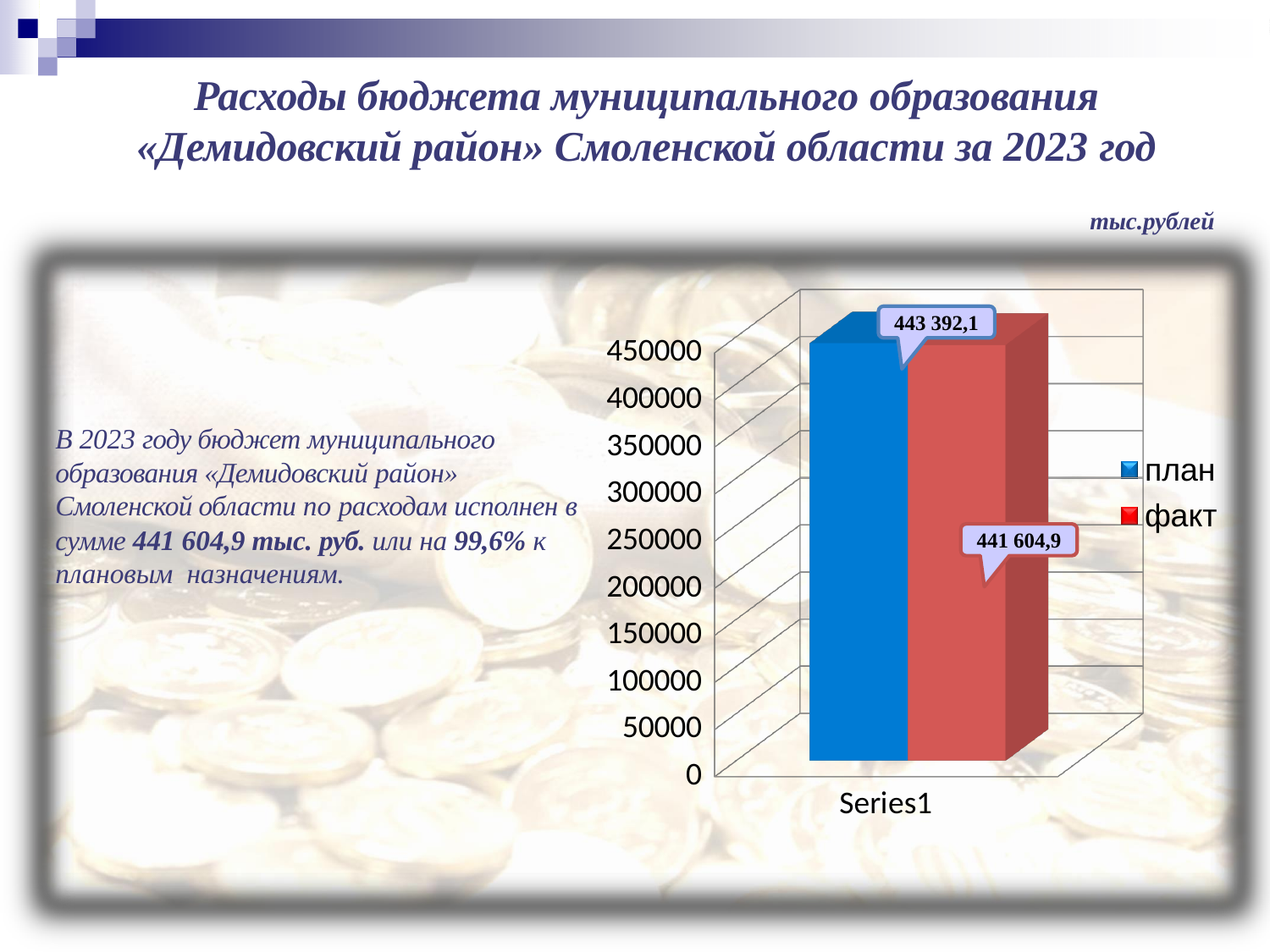
What colour is the факт series in the chart? red Is the value for факт greater or less than 400000? greater What unit is stated above the chart? тыс.рублей How many categories are shown on the x axis? 1 What is the value of the план (plan) bar? 443 392,1 What kind of chart is shown on the slide? bar chart What is the highest tick value shown on the vertical axis? 450000 What is the difference between the план value and the факт value? 1 787,2 How many series does the legend list? 2 What is the value of the факт (actual) bar? 441 604,9 Which series has the higher value according to the data labels, план or факт? план Is the value for план greater or less than 350000? greater